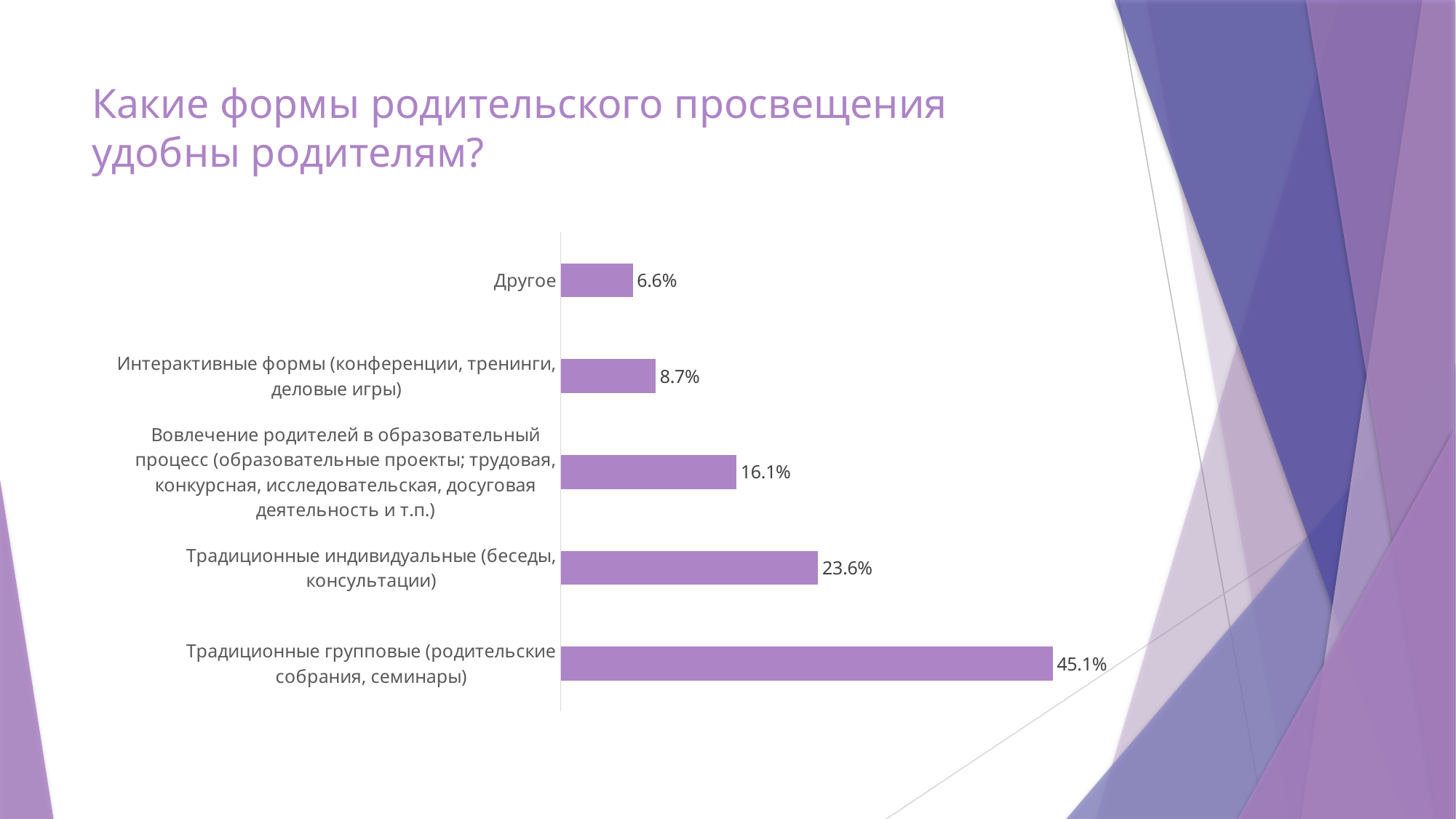
What is the difference between Традиционные групповые and Традиционные индивидуальные? 21.5% What is the title of the slide? Какие формы родительского просвещения удобны родителям? How many categories are shown in the chart? 5 Which is larger: Интерактивные формы or Вовлечение родителей в образовательный процесс? Вовлечение родителей в образовательный процесс What is the value for Другое? 6.6% What is the value for Традиционные индивидуальные (беседы, консультации)? 23.6% What is the value for Вовлечение родителей в образовательный процесс? 16.1% What is the value for Интерактивные формы (конференции, тренинги, деловые игры)? 8.7% What is the value for Традиционные групповые (родительские собрания, семинары)? 45.1% Which category has the lowest value? Другое What kind of chart is shown on the slide? Bar chart Which category has the highest value? Традиционные групповые (родительские собрания, семинары)